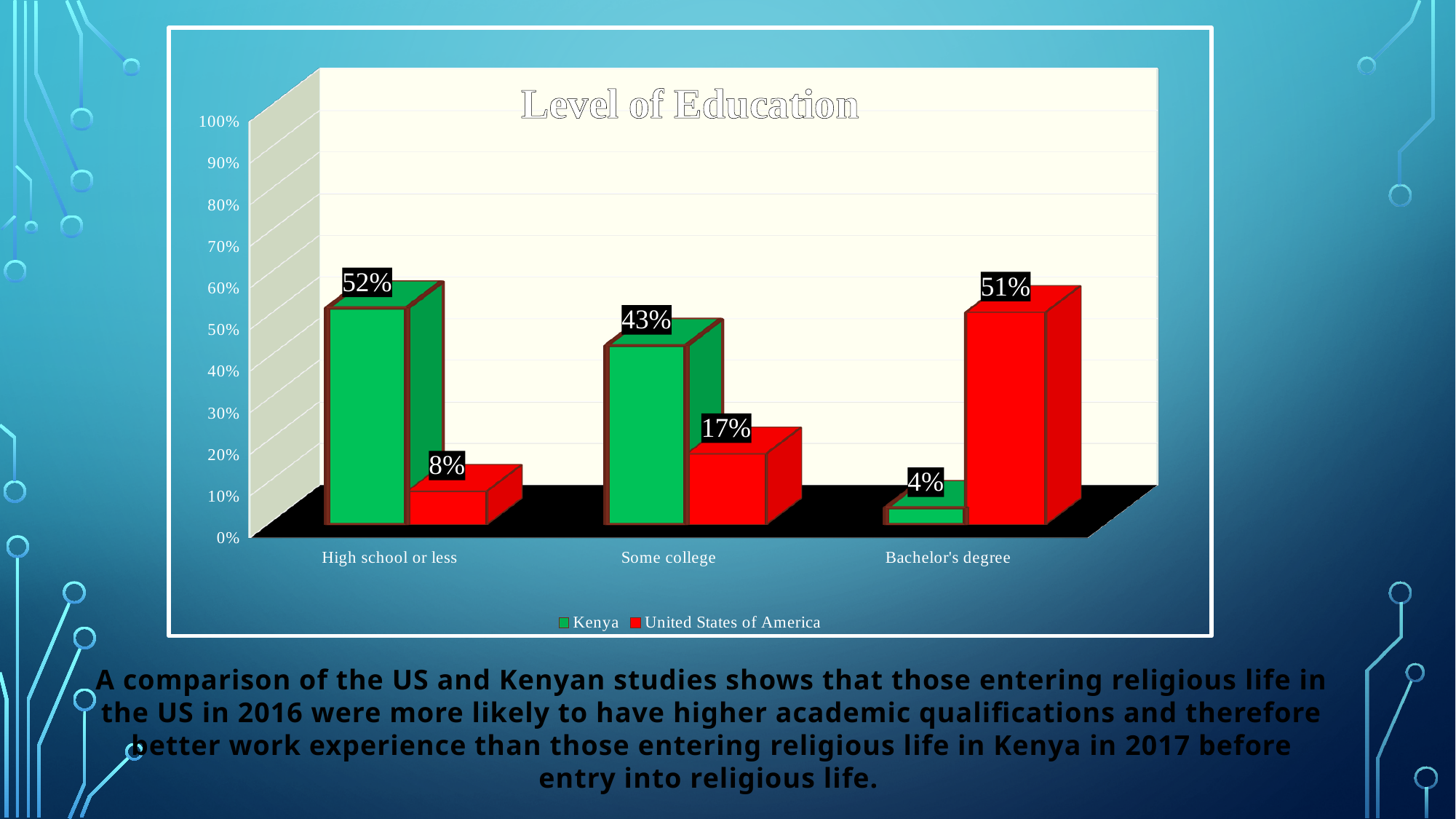
Which category has the lowest value for the United States of America series? High school or less What is the difference between the Kenya and United States of America values in the Some college category? 26% What kind of chart is shown on the slide? Bar chart What is the value for United States of America in the Bachelor's degree category? 51% What is the value for Kenya in the Bachelor's degree category? 4% Which is larger in the Bachelor's degree category: Kenya or United States of America? United States of America What is the title of the chart? Level of Education Which category has the highest value for the Kenya series? High school or less What is the value for Kenya in the High school or less category? 52% How many categories are shown on the x axis? 3 How many series does the legend list? 2 What is the value for United States of America in the Some college category? 17%